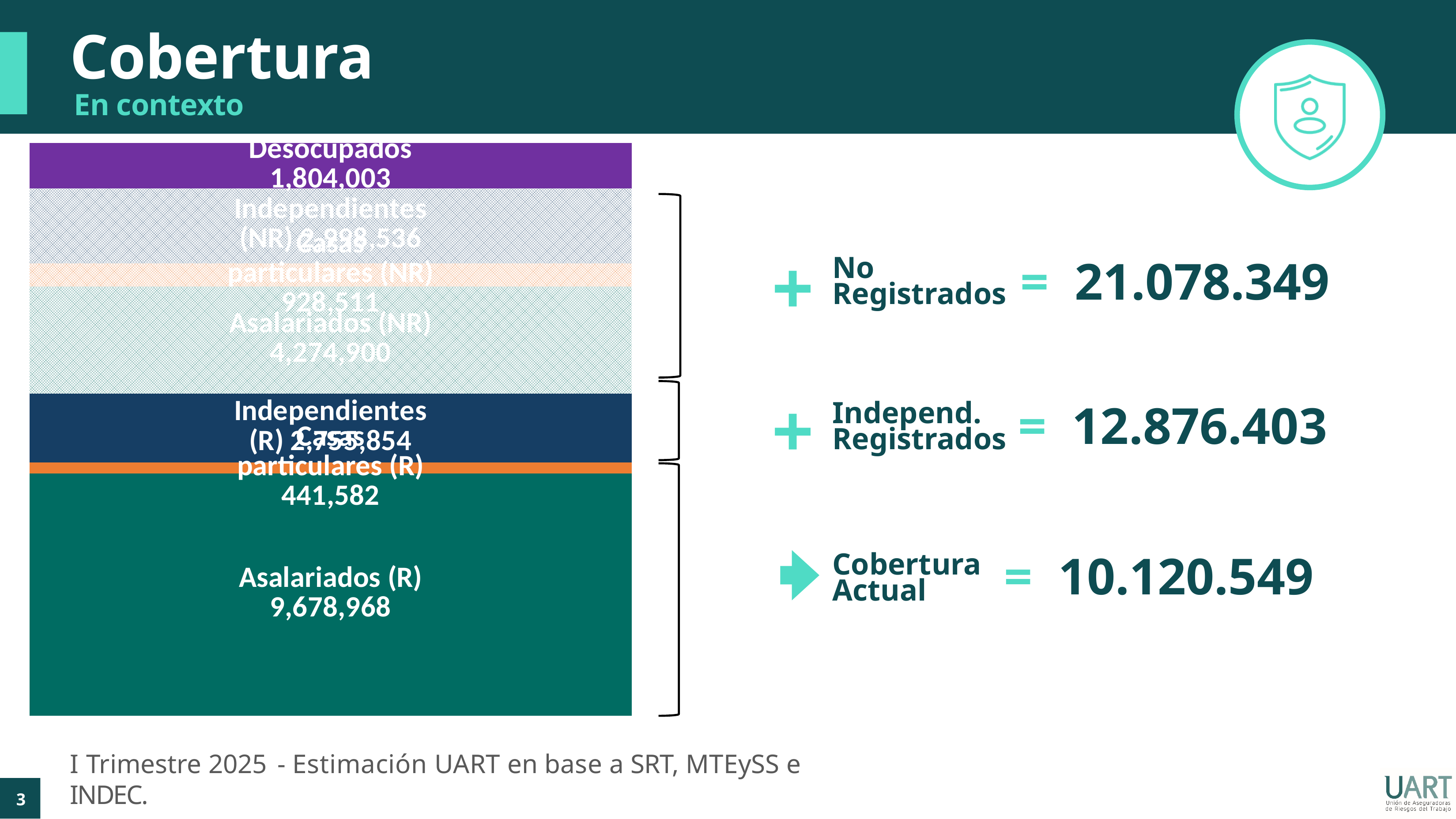
Which is larger, Desocupados or Asalariados (NR)? Asalariados (NR) What value is shown for the Asalariados (R) segment of the stacked bar? 9,678,968 What is the difference between the Desocupados and Casas particulares (NR) values? 875,492 What value is shown for the Asalariados (NR) segment? 4,274,900 Which segment of the stacked bar has the largest value? Asalariados (R) Which segment of the stacked bar has the smallest value? Casas particulares (R) What kind of chart is shown on the slide? Stacked bar chart What value is shown for the Casas particulares (NR) segment? 928,511 What value is shown for the Desocupados segment of the stacked bar? 1,804,003 What value is shown for the Casas particulares (R) segment? 441,582 What is the difference between the Asalariados (R) and Asalariados (NR) values? 5,404,068 How many segments make up the stacked bar? 7